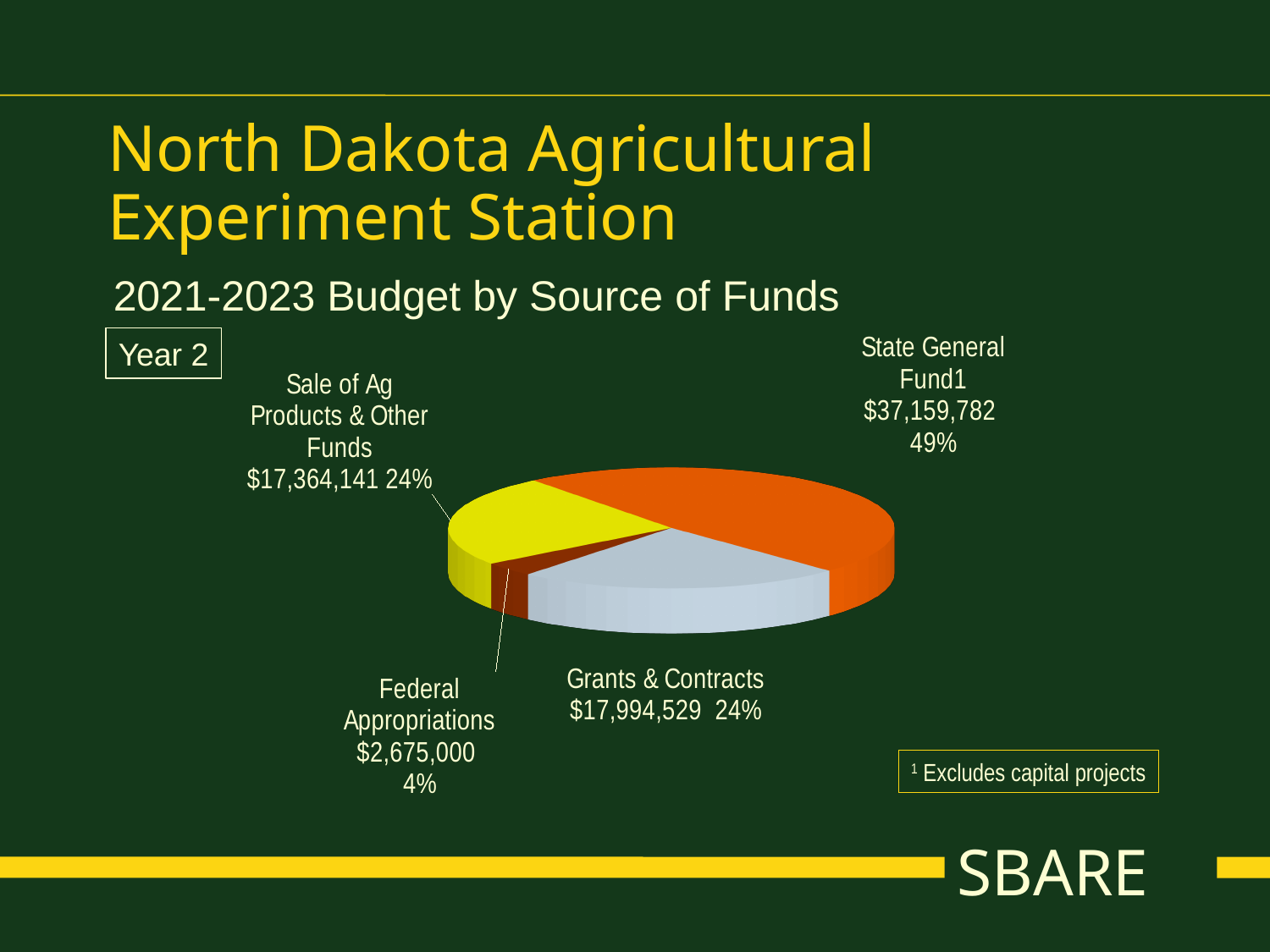
What percentage share does Federal Appropriations have? 4% What does the footnote on the slide say the State General Fund excludes? Capital projects Which is larger, the value for State General Fund or the value for Federal Appropriations? State General Fund What is the difference in dollars between Grants & Contracts and Sale of Ag Products & Other Funds? $630,388 How many slices does the pie chart have? 4 Which source of funds has the smallest share? Federal Appropriations What is the dollar value for Grants & Contracts? $17,994,529 What percentage share does State General Fund have? 49% Which source of funds has the largest share? State General Fund What type of chart is shown on the slide? Pie chart What is the dollar value for State General Fund? $37,159,782 What is the dollar value for Sale of Ag Products & Other Funds? $17,364,141